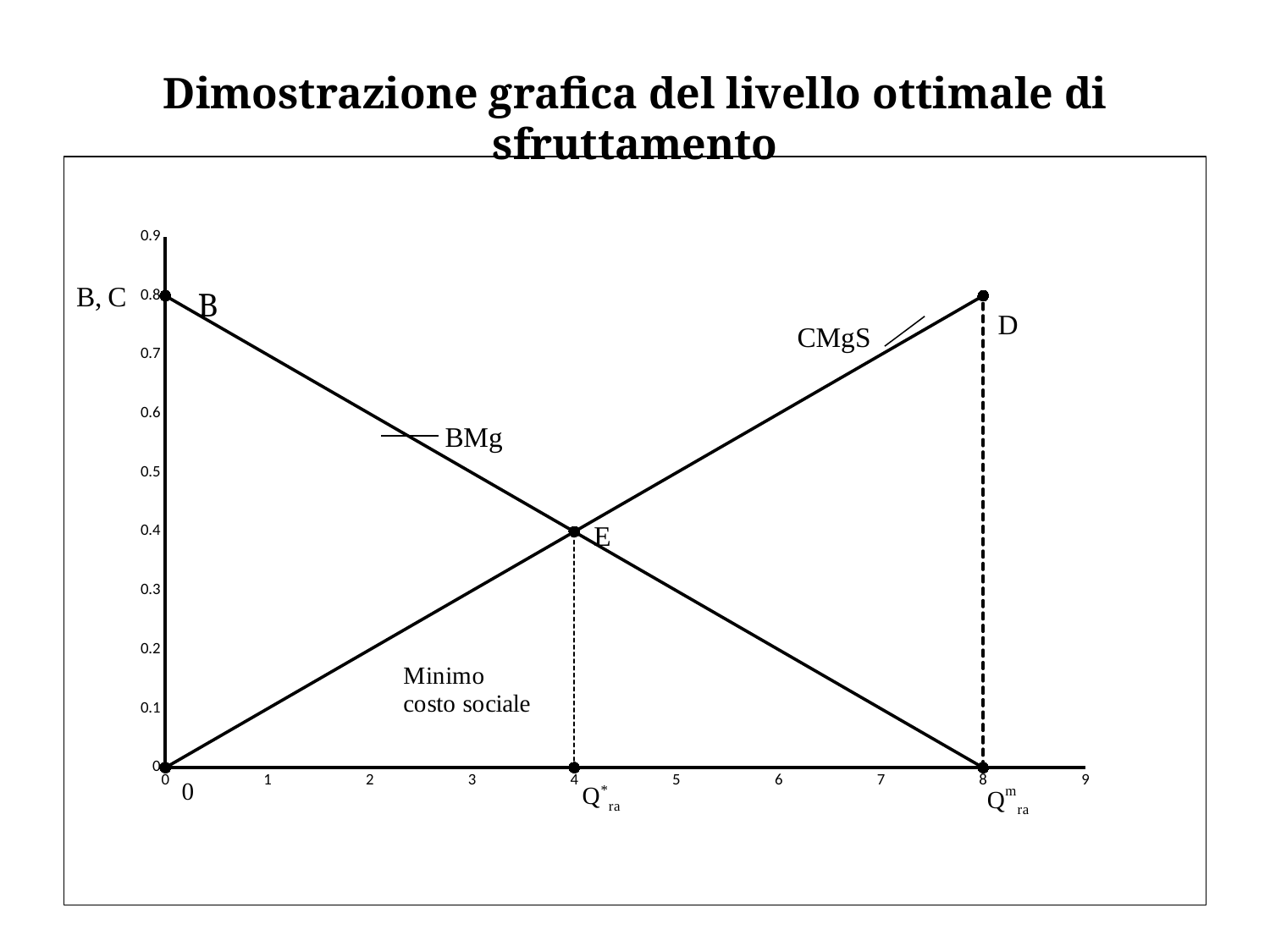
What kind of chart is shown on the slide? line chart What is the value of BMg at quantity 0 (point B)? 0.8 At quantity 2, which line is higher, BMg or CMgS? BMg What is the difference between the value of BMg at quantity 0 and its value at point E? 0.4 What is the value of CMgS at quantity 8 (point D)? 0.8 At quantity 6, which line is higher, BMg or CMgS? CMgS Does the BMg line rise or fall as the quantity on the x axis increases? fall How many lines are plotted on the chart? 2 Does the CMgS line rise or fall as the quantity on the x axis increases? rise At what quantity on the x axis do the BMg and CMgS lines intersect (point E)? 4 Is the value of CMgS at quantity 2 greater or less than 0.3? less What is the value on the vertical axis at the intersection point E? 0.4